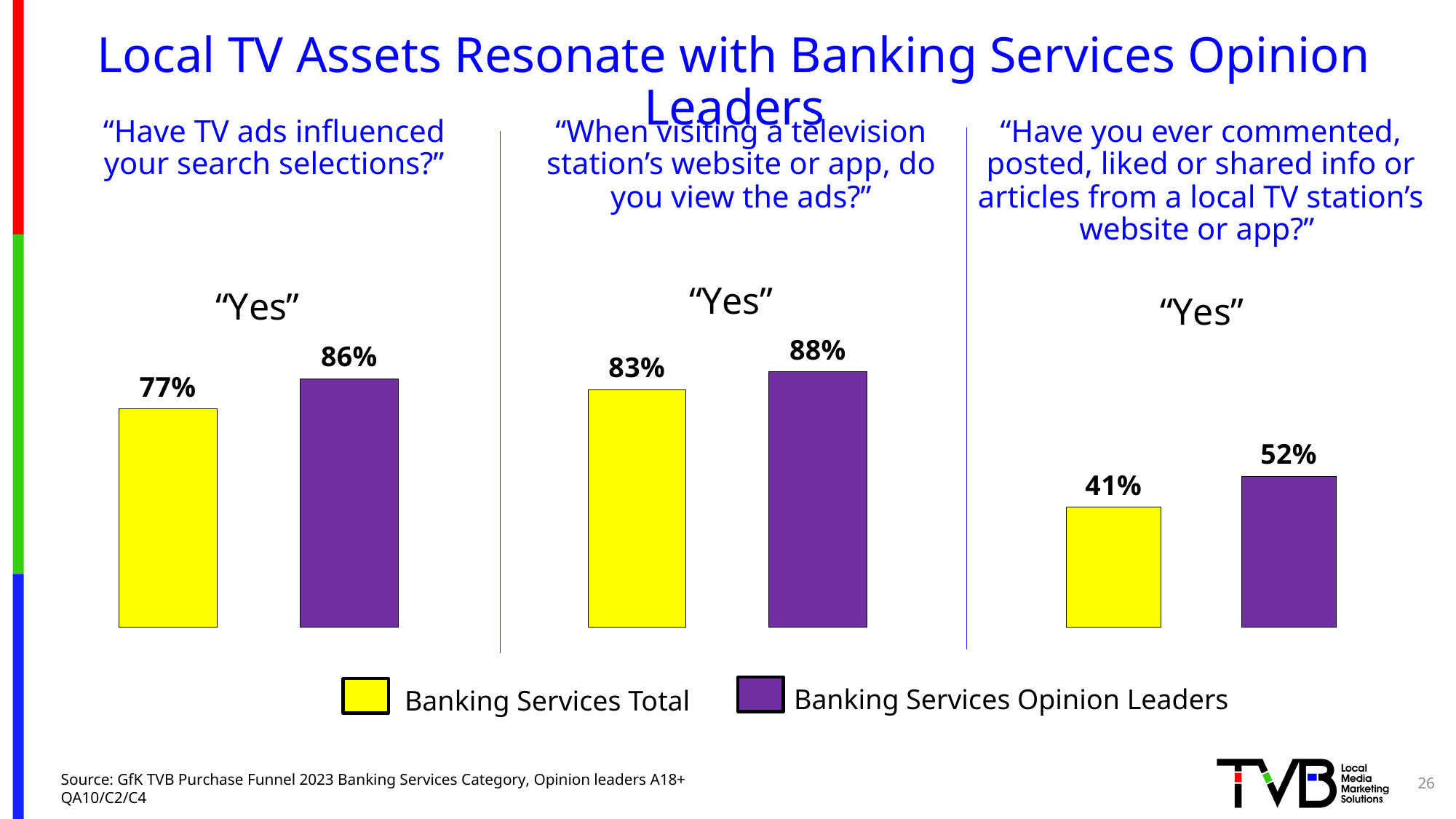
In the middle chart ("When visiting a television station's website or app, do you view the ads?"), what is the value for Banking Services Total? 83% In the left chart ("Have TV ads influenced your search selections?"), which group has the higher value? Banking Services Opinion Leaders In the left chart ("Have TV ads influenced your search selections?"), what is the value for Banking Services Opinion Leaders? 86% In the middle chart ("When visiting a television station's website or app, do you view the ads?"), what is the value for Banking Services Opinion Leaders? 88% How many series does the legend list? 2 In the right chart ("Have you ever commented, posted, liked or shared info or articles from a local TV station's website or app?"), what is the difference between Banking Services Opinion Leaders and Banking Services Total? 11 percentage points In the right chart ("Have you ever commented, posted, liked or shared info or articles from a local TV station's website or app?"), what is the value for Banking Services Opinion Leaders? 52% In the left chart ("Have TV ads influenced your search selections?"), what is the value for Banking Services Total? 77% Across all three charts, which chart shows the lowest value for Banking Services Total? The right chart ("Have you ever commented, posted, liked or shared info or articles from a local TV station's website or app?") What colour represents Banking Services Opinion Leaders in the legend? Purple What kind of chart is used on this slide? Bar chart In the middle chart ("When visiting a television station's website or app, do you view the ads?"), what is the difference between the two bars? 5 percentage points